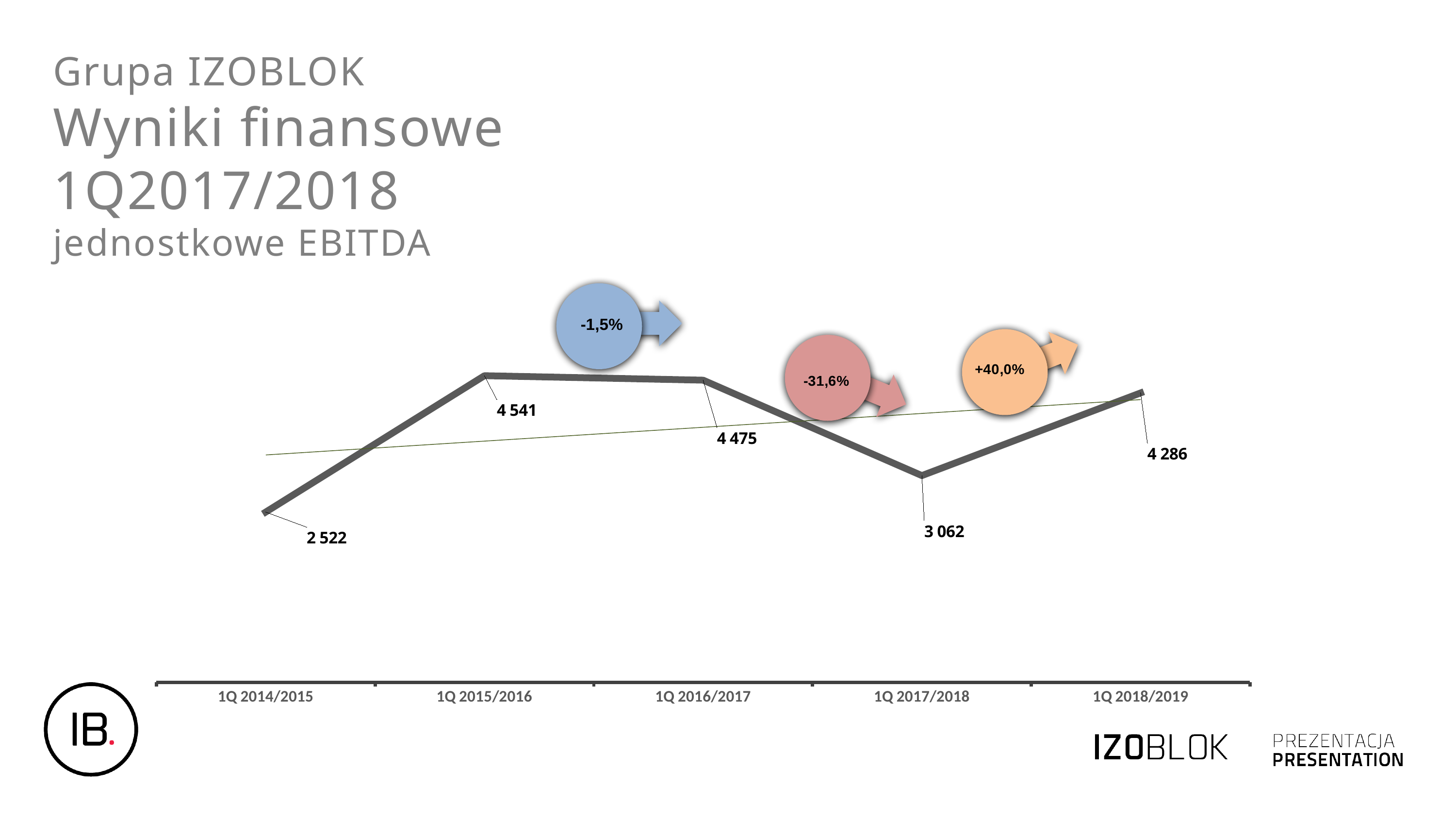
What is the difference between the EBITDA values for 1Q 2016/2017 and 1Q 2017/2018? 1 413 Which period has the highest EBITDA value? 1Q 2015/2016 Does the EBITDA value rise or fall from 1Q 2017/2018 to 1Q 2018/2019? rise What kind of chart is shown on the slide? line chart Which period has the lowest EBITDA value? 1Q 2014/2015 Which is larger, the EBITDA value for 1Q 2016/2017 or for 1Q 2018/2019? 1Q 2016/2017 What percentage change is shown in the red circle between 1Q 2016/2017 and 1Q 2017/2018? -31,6% How many periods are plotted on the chart? 5 What is the EBITDA value for 1Q 2018/2019? 4 286 What is the EBITDA value for 1Q 2014/2015? 2 522 What is the EBITDA value for 1Q 2017/2018? 3 062 What is the EBITDA value for 1Q 2015/2016? 4 541